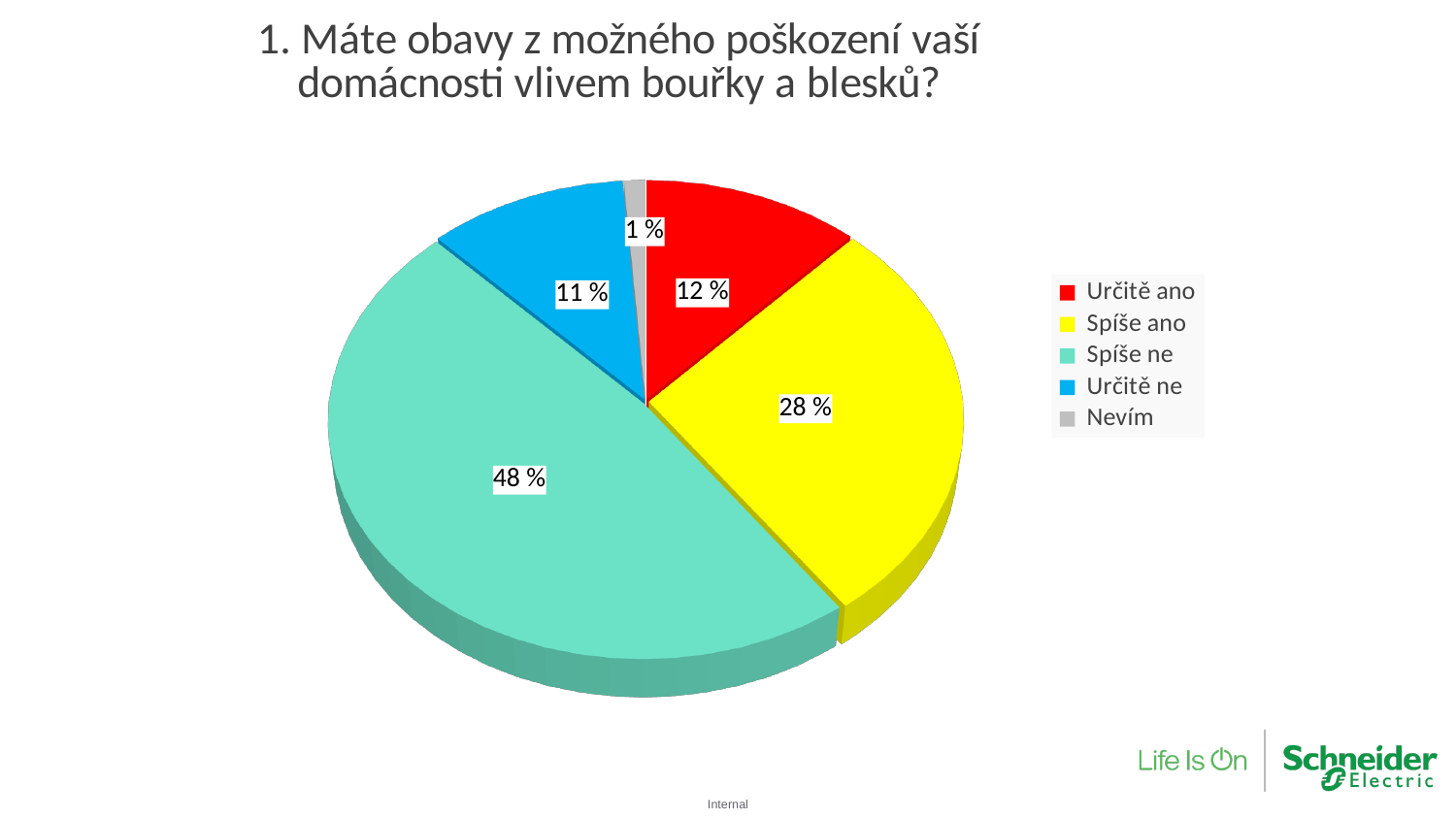
Which is larger, the share for "Určitě ano" or the share for "Určitě ne"? Určitě ano What is the value for "Určitě ne"? 11 % What is the value for "Nevím"? 1 % What share of the pie does "Spíše ne" have? 48 % What is the value for "Určitě ano"? 12 % How many categories does the legend list? 5 Which category has the smallest share of the pie? Nevím What is the difference between the shares of "Spíše ne" and "Spíše ano"? 20 % What kind of chart is shown on the slide? Pie chart Which category has the largest share of the pie? Spíše ne What is the value for "Spíše ano"? 28 % What colour is the slice for "Spíše ano"? Yellow